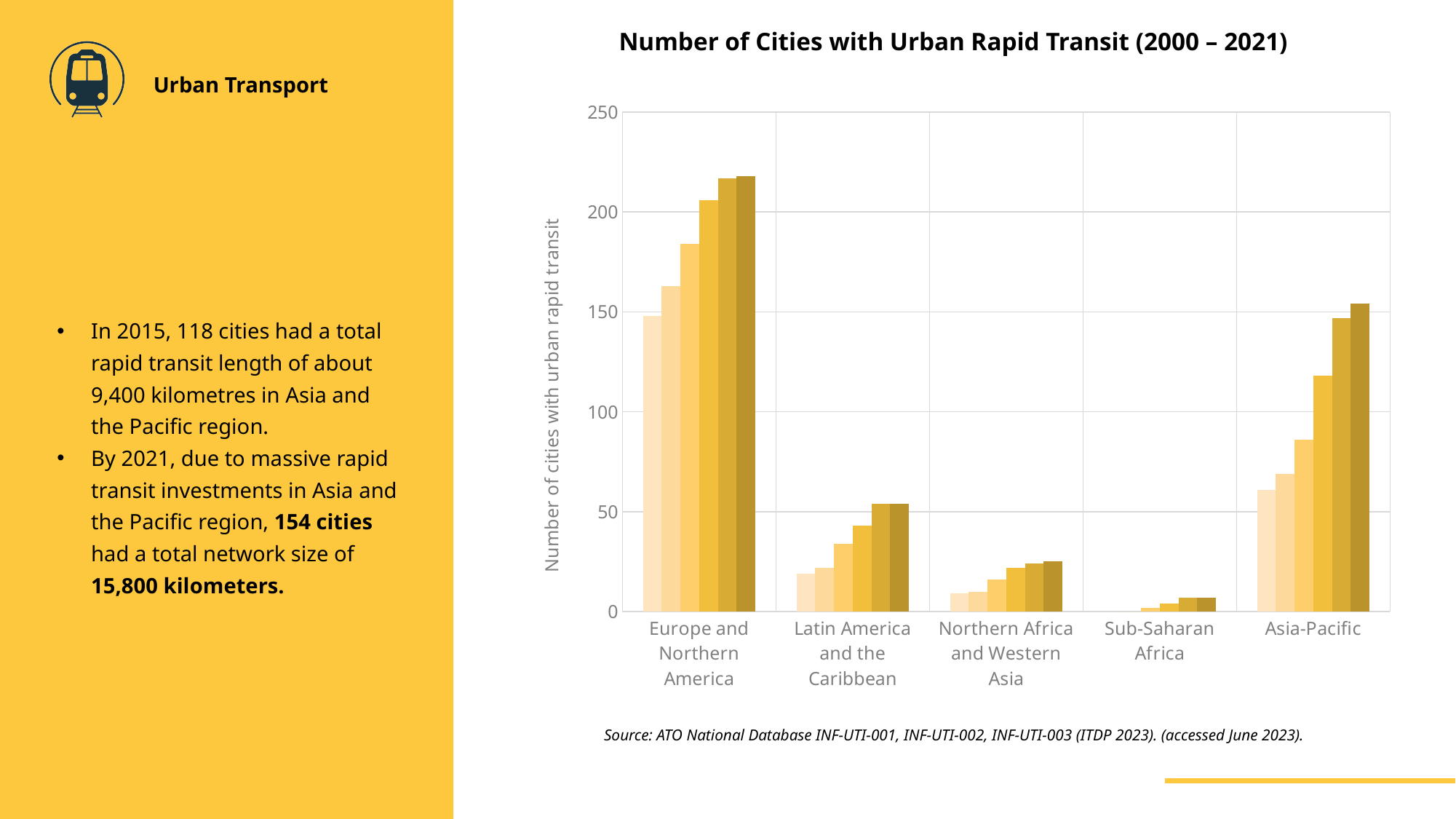
How many regions are shown along the x axis of the chart? 5 How many bars are plotted for each region in the chart? 6 Is the tallest bar for Asia-Pacific greater or less than 100? greater What is the title of the chart? Number of Cities with Urban Rapid Transit (2000 – 2021) Within each region, do the bars rise or fall from left to right? rise Is the tallest bar for Latin America and the Caribbean greater or less than 100? less Which region has the highest number of cities with urban rapid transit? Europe and Northern America Is the tallest bar for Europe and Northern America greater or less than 200? greater Which region has more cities with urban rapid transit in its tallest bar, Asia-Pacific or Latin America and the Caribbean? Asia-Pacific Which region has the lowest number of cities with urban rapid transit? Sub-Saharan Africa What kind of chart is shown on the slide? bar chart